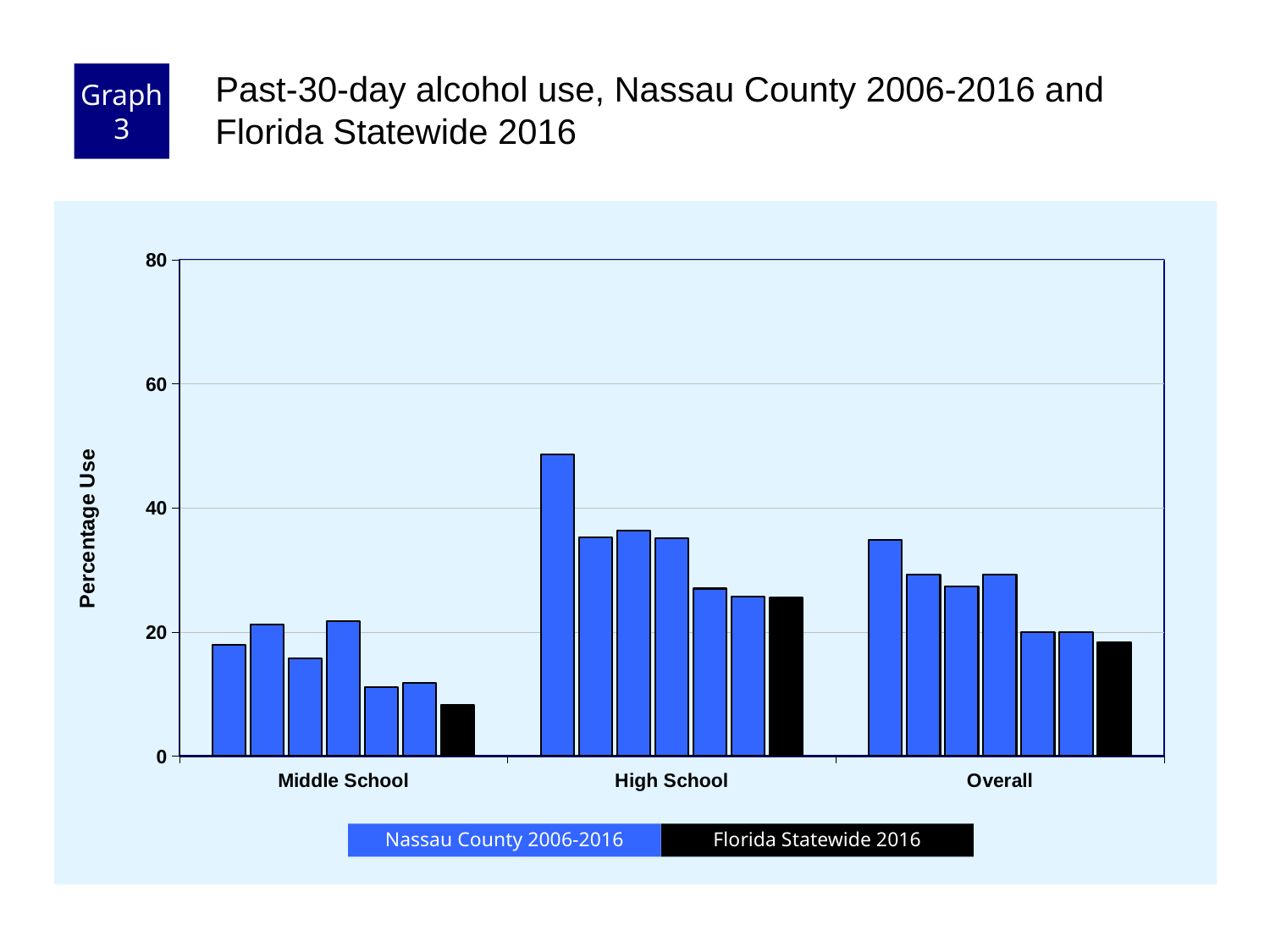
How many categories are shown on the x axis? 3 Is the Florida Statewide 2016 value for Middle School greater or less than 20? less Which colour represents Florida Statewide 2016 in the legend? black What kind of chart is shown on the slide? bar chart Within the High School group, do the Nassau County 2006-2016 bars generally rise or fall from left to right? fall What is the label of the y axis? Percentage Use Is the Florida Statewide 2016 value for High School greater or less than 20? greater How many series does the legend list? 2 Is the Florida Statewide 2016 value for Overall greater or less than 40? less Which category has the highest Florida Statewide 2016 value? High School Which category has the lowest Florida Statewide 2016 value? Middle School